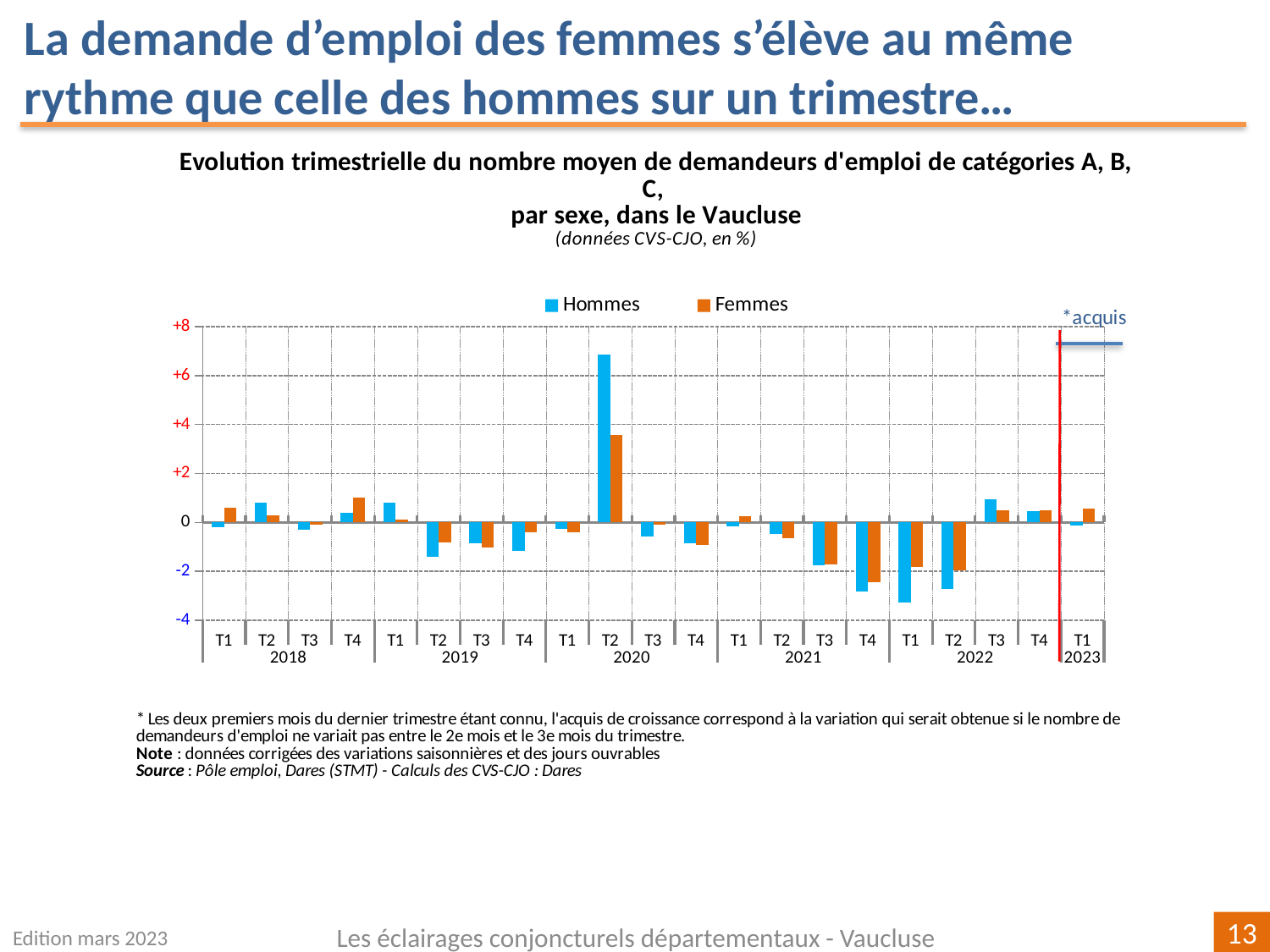
In which quarter is the Femmes value lowest? T4 2021 In which quarter is the Femmes value highest? T2 2020 In T4 2018, which series has the larger value, Hommes or Femmes? Femmes Which colour represents the Femmes series in the chart? orange In T2 2020, which series has the larger value, Hommes or Femmes? Hommes How many series does the legend list? 2 Is the Hommes value for T2 2020 greater or less than +6? greater In which quarter is the Hommes value highest? T2 2020 What kind of chart is shown on the slide? bar chart How many quarters are plotted along the x axis? 21 Is the Hommes value for T1 2022 greater or less than -2? less In which quarter is the Hommes value lowest? T1 2022